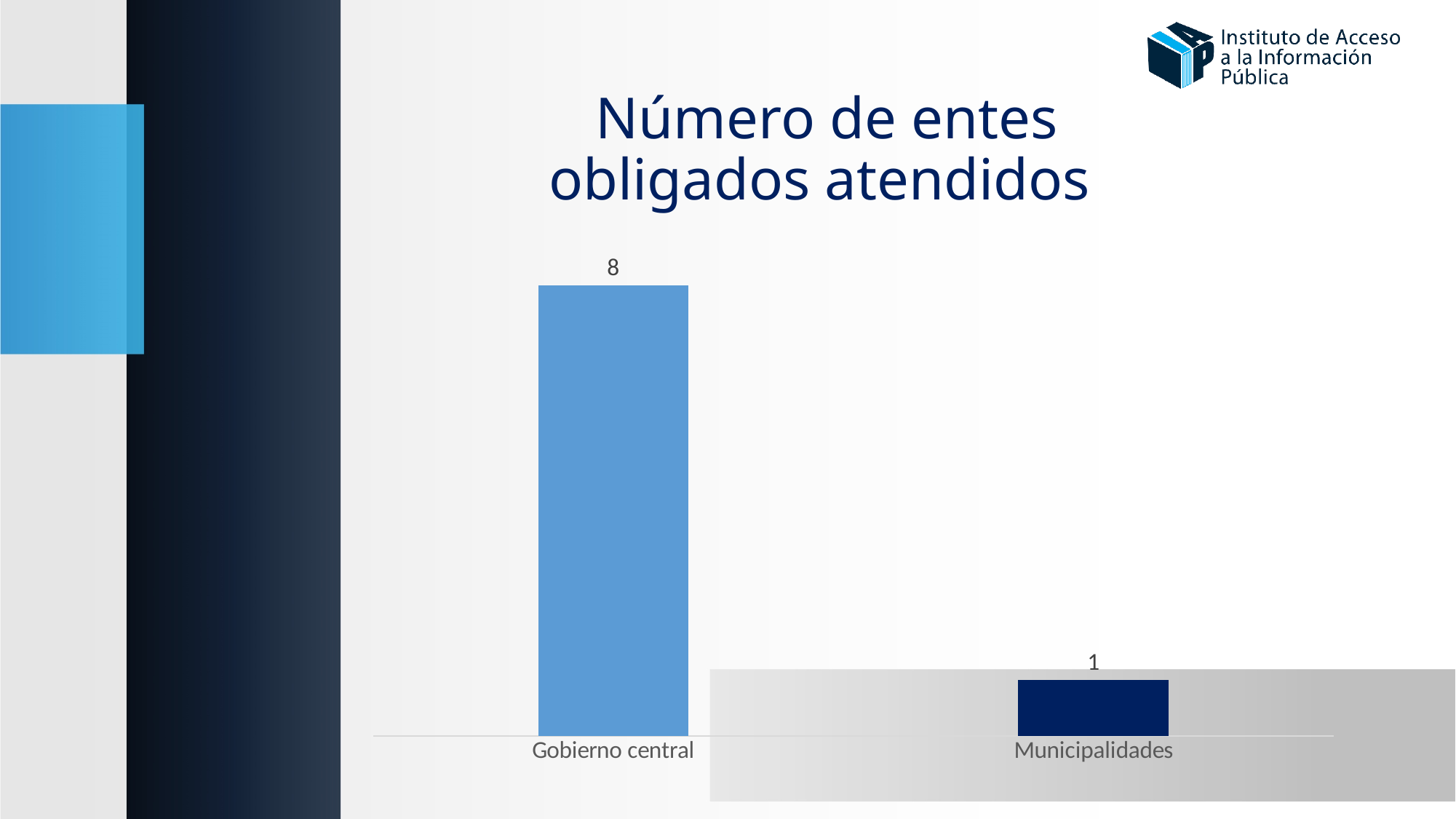
Which category has the highest value? Gobierno central What kind of chart is shown on the slide? Bar chart What is the value for Gobierno central? 8 How many categories are shown in the chart? 2 What is the difference between the values for Gobierno central and Municipalidades? 7 Which is larger, the value for Gobierno central or the value for Municipalidades? Gobierno central What is the title of the chart? Número de entes obligados atendidos Which category has the lowest value? Municipalidades What is the value for Municipalidades? 1 What colour is the bar for Municipalidades? Dark navy blue Do the values rise or fall from Gobierno central to Municipalidades? Fall